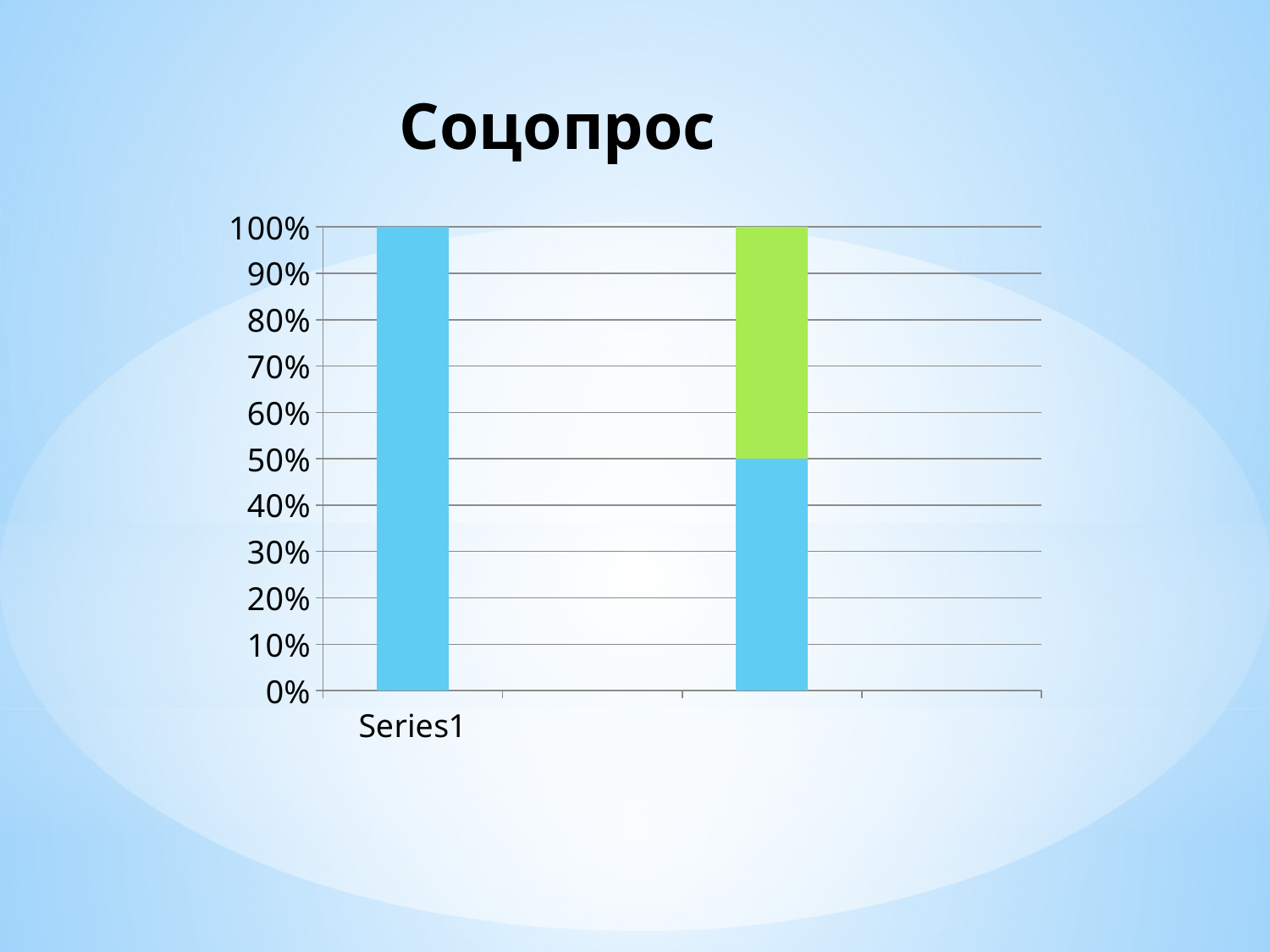
What kind of chart is shown on the slide? Bar chart Is the value for Series1 greater or less than 90%? greater Does the chart display a legend? No Is the value for Series1 greater or less than 50%? greater How many bars are plotted in the chart? 2 What value does the bar for Series1 reach on the y-axis? 100% What is the title of the chart? Соцопрос